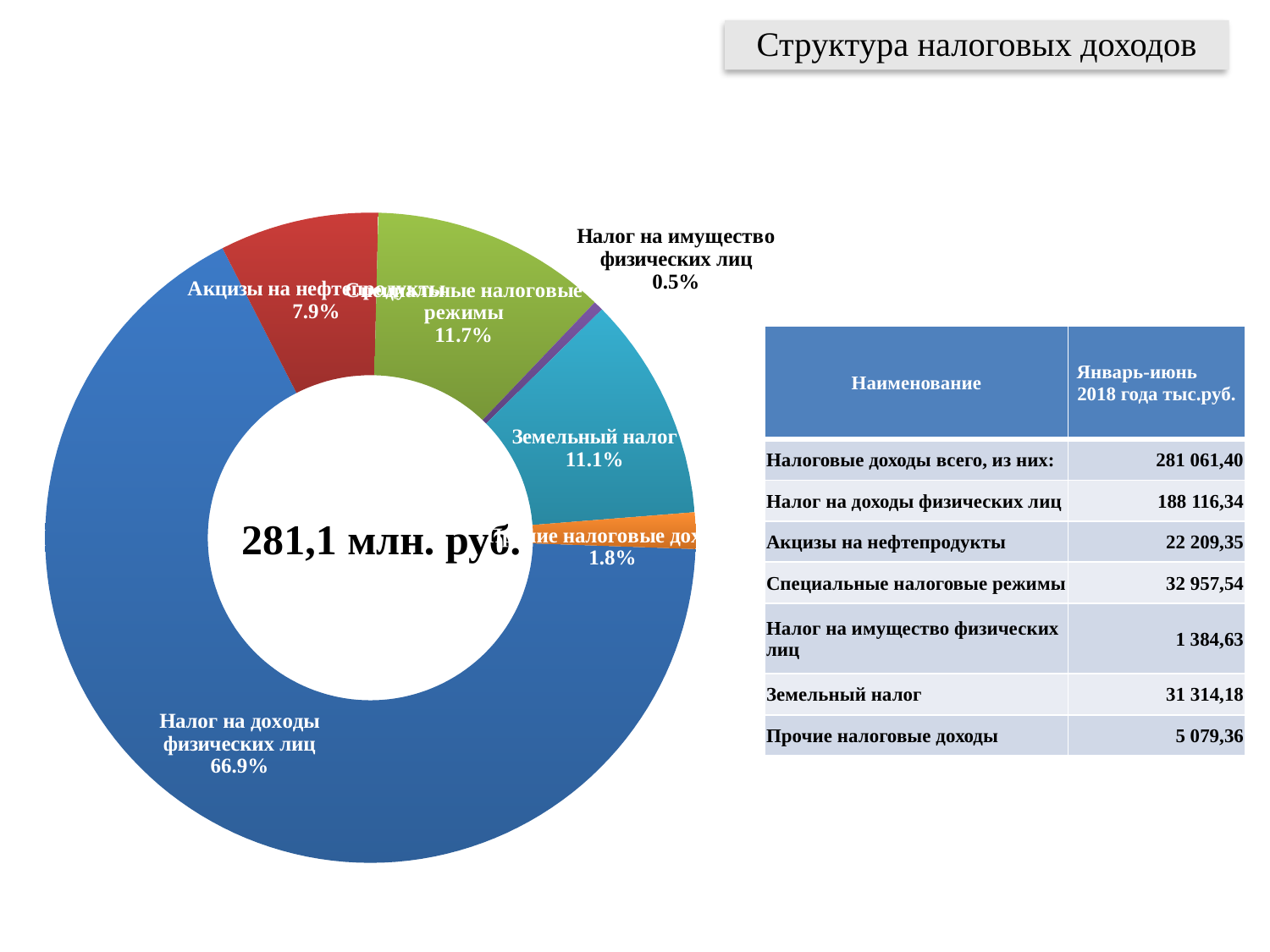
How many slices does the doughnut chart have? 6 What percentage is shown for Земельный налог in the doughnut chart? 11.1% What is the difference in percentage points between the shares of Налог на доходы физических лиц and Земельный налог? 55.8 Which has a larger share in the doughnut chart, Специальные налоговые режимы or Земельный налог? Специальные налоговые режимы What percentage is shown for Налог на имущество физических лиц in the doughnut chart? 0.5% What total value is printed in the centre of the doughnut chart? 281,1 млн. руб. Which category has the smallest share in the doughnut chart? Налог на имущество физических лиц What is the title of the slide containing the chart? Структура налоговых доходов What type of chart is shown on the slide? Doughnut (pie) chart What percentage is shown for Специальные налоговые режимы in the doughnut chart? 11.7% What share of the doughnut chart does Налог на доходы физических лиц represent? 66.9% Which category has the largest share in the doughnut chart? Налог на доходы физических лиц